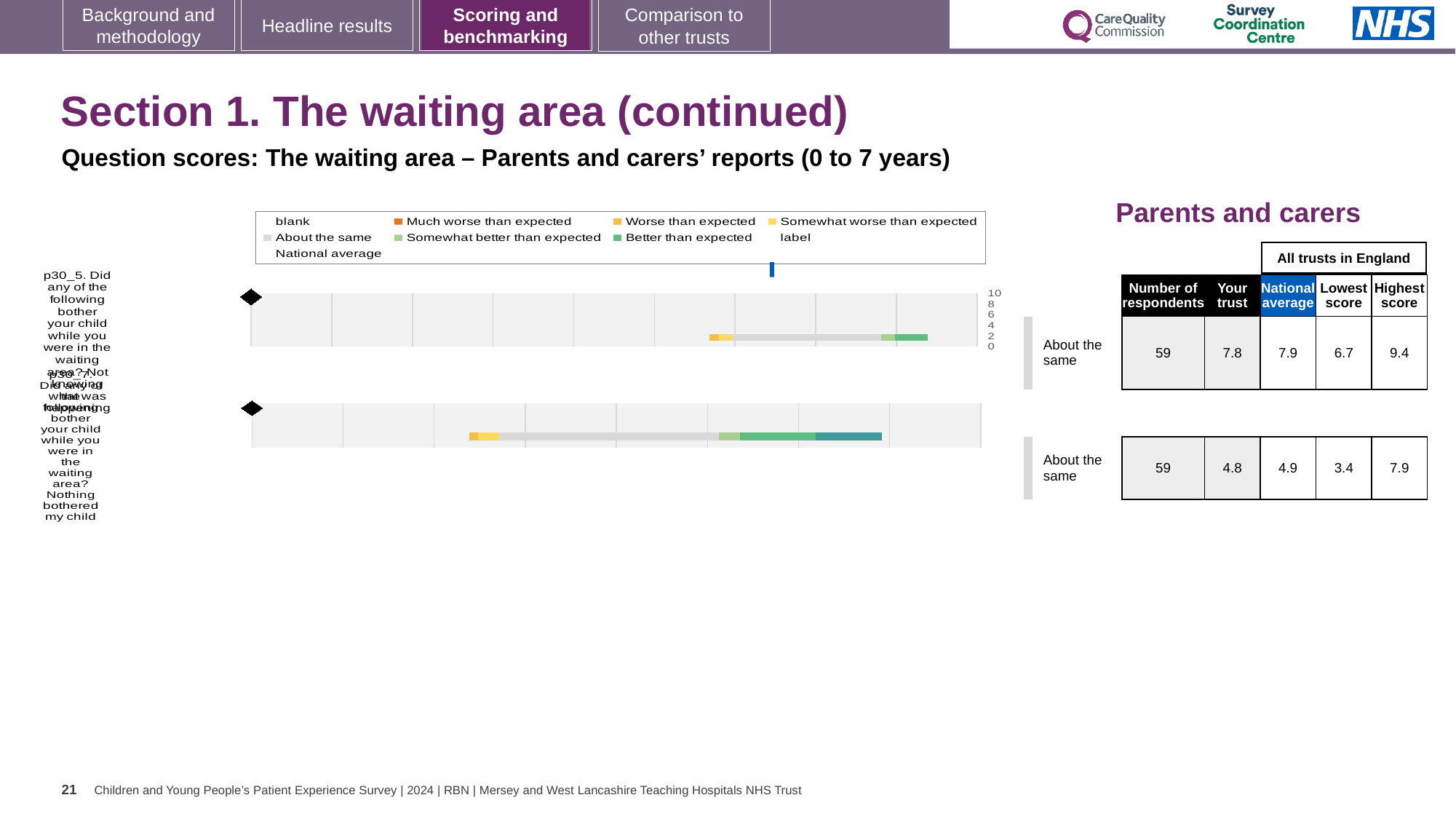
What kind of chart is shown on the slide? bar chart In the table, what is the national average for the second question (p30_7, Nothing bothered my child)? 4.9 How many questions (bars) are plotted in the chart? 2 Which legend entry is shown with a dark green colour? Better than expected What is the difference between the highest and lowest scores for question p30_7? 4.5 What is the lowest score among all trusts in England for question p30_5? 6.7 How many respondents answered question p30_5? 59 In the table, what is the 'Your trust' score for the first question (p30_5, Not knowing what was happening)? 7.8 What benchmark category is the trust placed in for question p30_7? About the same What is the difference between the highest and lowest scores for question p30_5? 2.7 Which is larger for question p30_5: the trust's score or the national average? national average What is the highest score among all trusts in England for question p30_7? 7.9